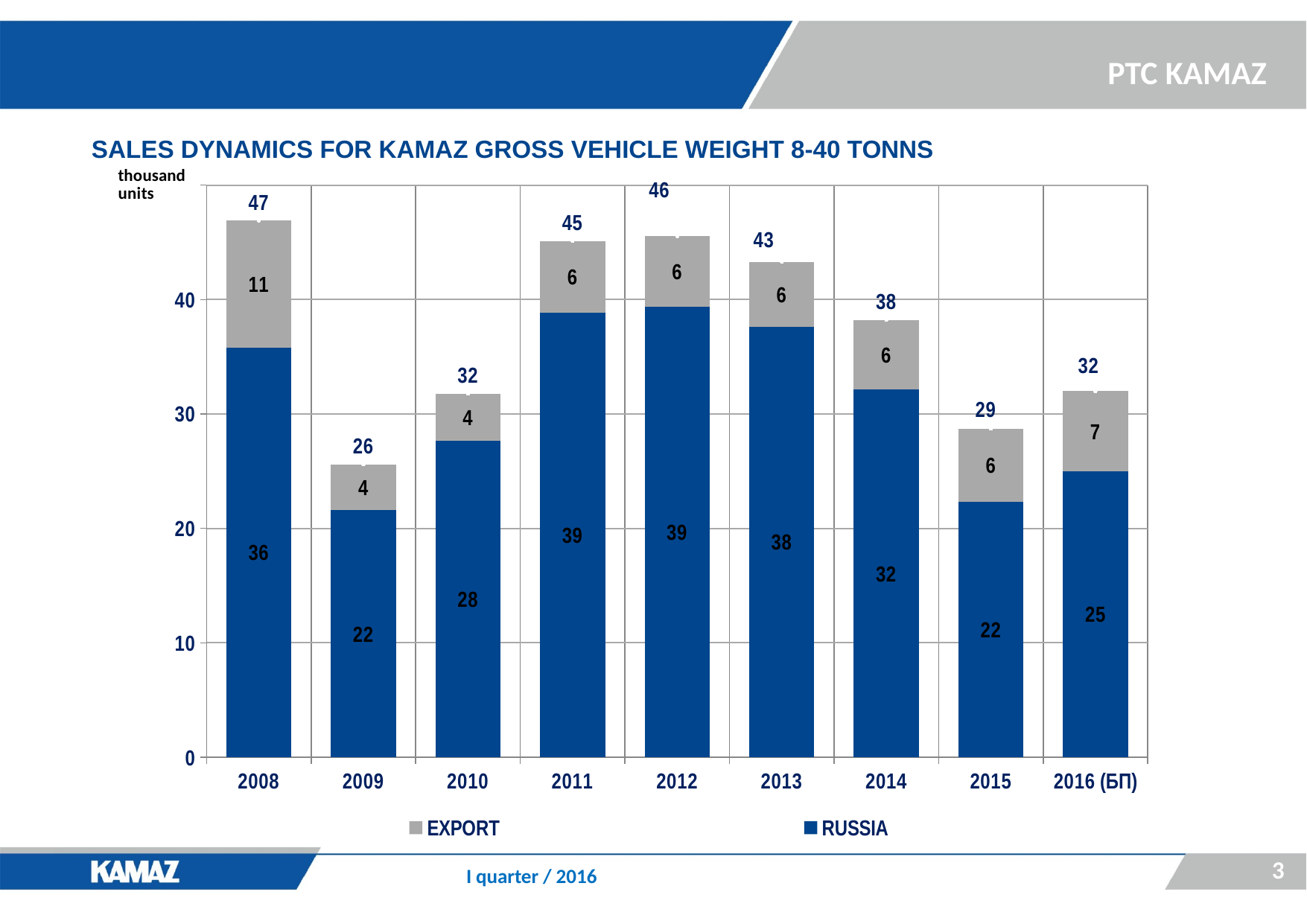
How many series does the legend list? 2 What unit is stated for the values on the chart? thousand units Do the total sales rise or fall from 2012 to 2015? Fall What is the EXPORT value for 2008? 11 What is the difference between the RUSSIA values for 2008 and 2009? 14 How many years are shown on the x axis? 9 What is the RUSSIA value for 2010? 28 Which year has the highest total sales? 2008 Which is larger, the EXPORT value for 2015 or for 2016 (БП)? 2016 (БП) What is the total shown above the 2011 bar? 45 Which year has the lowest total sales? 2009 What kind of chart is shown on the slide? Stacked bar chart